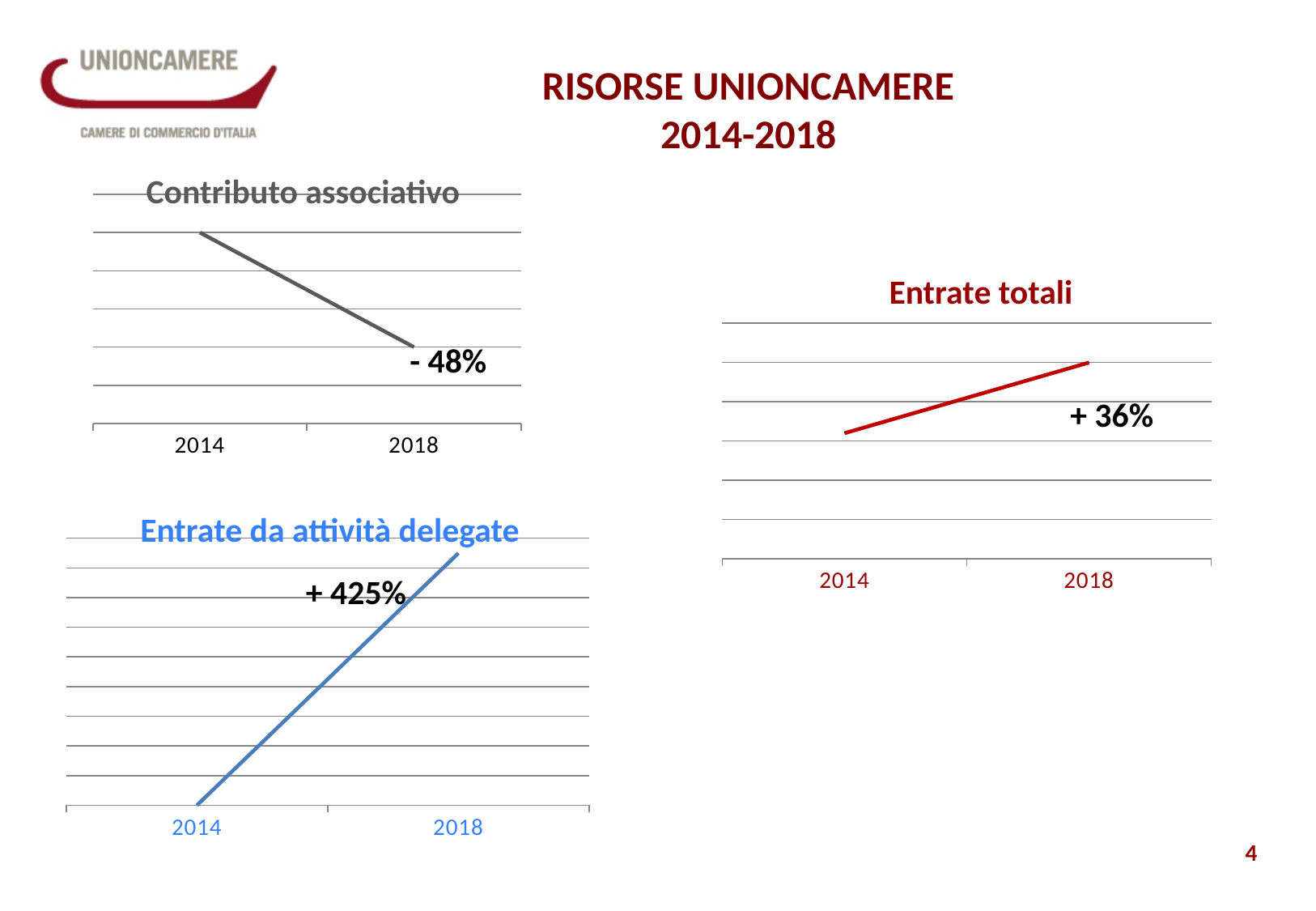
In the "Contributo associativo" chart, does the value rise or fall from 2014 to 2018? fall In the "Contributo associativo" chart, which year has the lower value, 2014 or 2018? 2018 What colour is the line in the "Entrate totali" chart? red What kind of chart is the "Contributo associativo" chart? line chart What is the title of the chart at the bottom left of the slide? Entrate da attività delegate In the "Entrate totali" chart, which year has the higher value, 2014 or 2018? 2018 What percentage change is printed on the "Entrate totali" chart? + 36% How many years are shown on the x axis of the "Entrate totali" chart? 2 What percentage change is printed on the "Contributo associativo" chart? - 48% What percentage change is printed on the "Entrate da attività delegate" chart? + 425% In the "Entrate totali" chart, does the value rise or fall from 2014 to 2018? rise In the "Entrate da attività delegate" chart, does the value rise or fall from 2014 to 2018? rise